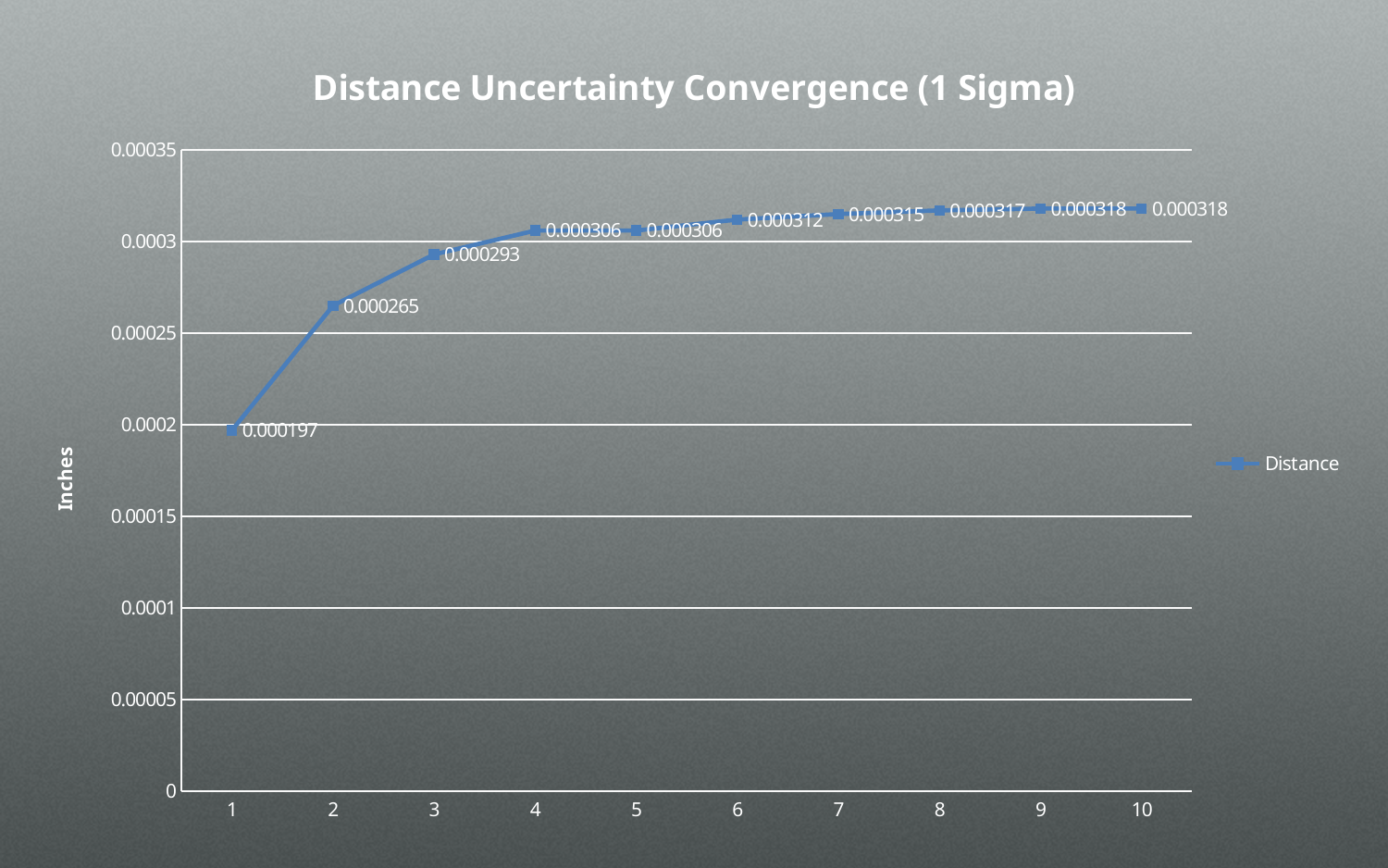
What is the value of Distance at x = 1? 0.000197 What is the difference between the Distance values at x = 2 and x = 1? 0.000068 What is the highest Distance value plotted on the chart? 0.000318 What is the value of Distance at x = 10? 0.000318 How many data points are plotted on the chart? 10 Which is larger, the Distance value at x = 2 or at x = 6? x = 6 What is the value of Distance at x = 3? 0.000293 What is the difference between the Distance values at x = 10 and x = 1? 0.000121 Do the Distance values generally rise or fall as x increases from 1 to 10? rise At which x value is the Distance lowest? 1 What type of chart is shown on the slide? line chart What is the value of Distance at x = 7? 0.000315